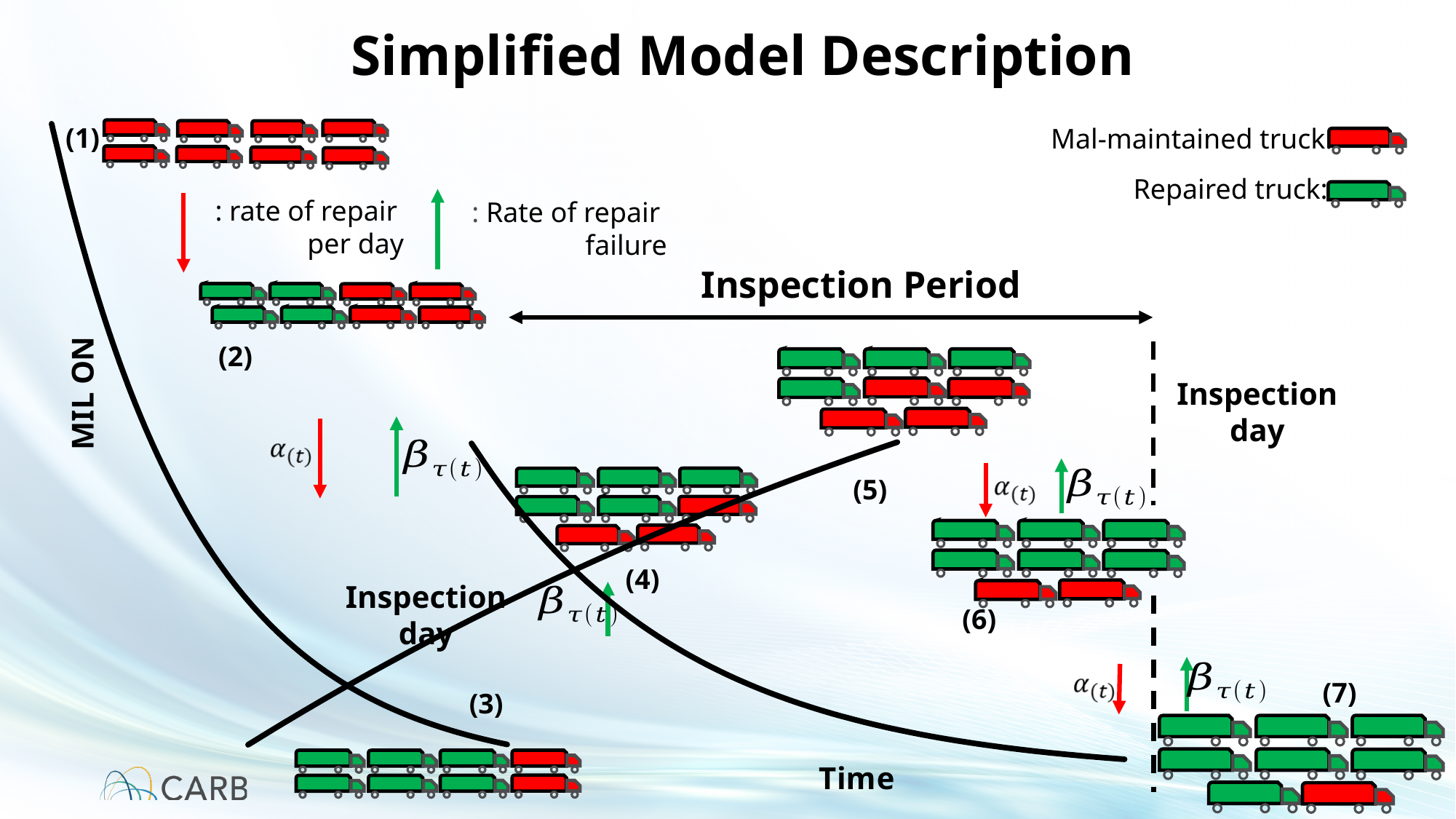
How many red (mal-maintained) trucks are shown in stage (1)? 8 How many green (repaired) trucks are shown in stage (2)? 4 How many truck types does the legend list? 2 How many numbered stages are shown in the diagram? 7 Which colour represents a repaired truck in the legend? green What is the label on the vertical axis of the diagram? MIL ON Which stage has more red trucks, stage (1) or stage (7)? stage (1) What is the title of the slide diagram? Simplified Model Description